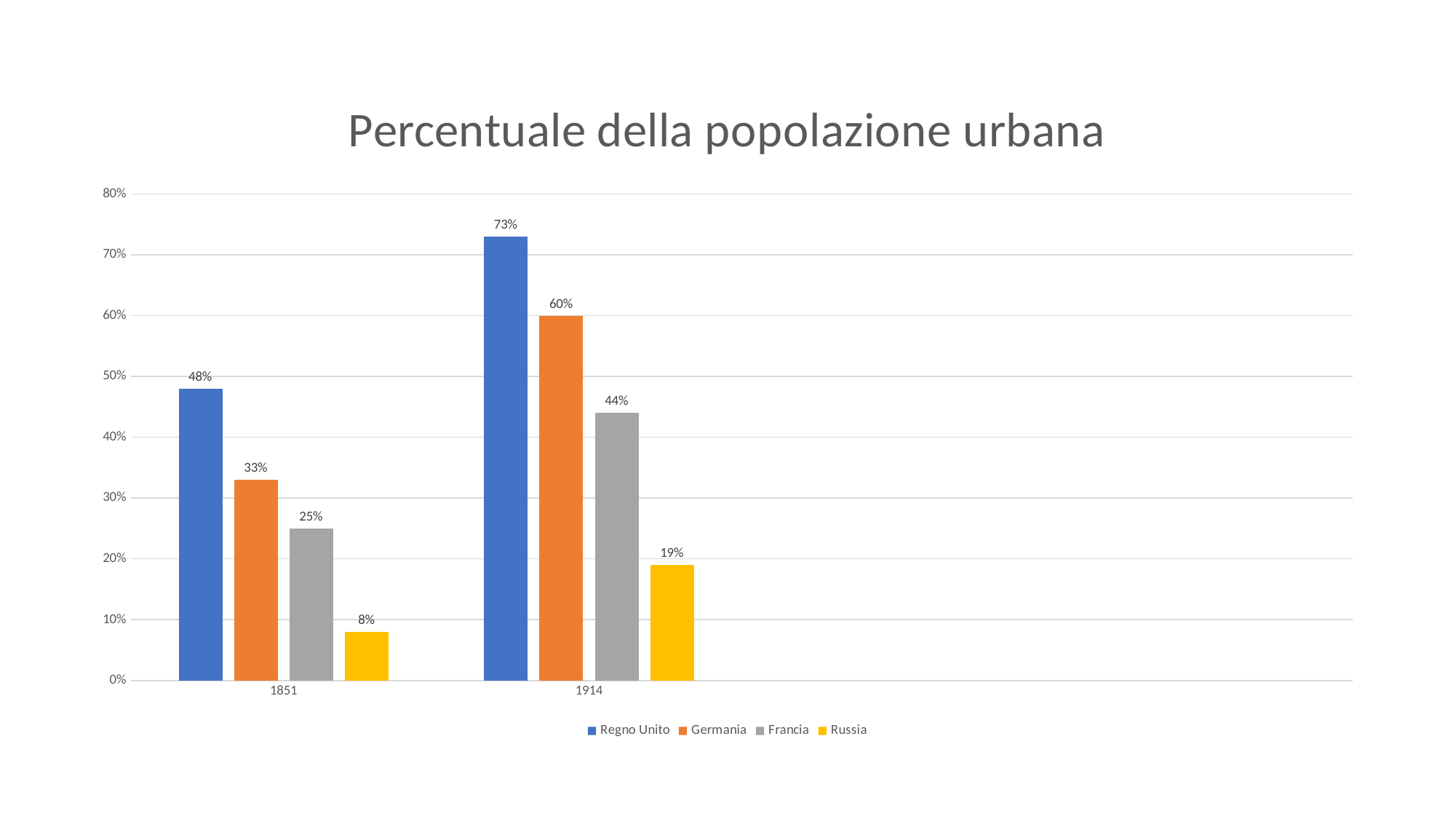
How many categories are shown on the x axis? 2 What is the value for Francia in 1914? 44% How many series does the legend list? 4 What is the value for Russia in 1914? 19% What is the title of the chart? Percentuale della popolazione urbana What is the difference between the Germania values for 1914 and 1851? 27% What is the value for Regno Unito in 1851? 48% Which is larger: Francia in 1914 or Regno Unito in 1851? Regno Unito in 1851 Which series has the lowest value in 1851? Russia Which series has the highest value in 1914? Regno Unito What kind of chart is shown on the slide? Bar chart Is the value for Germania in 1914 greater or less than 50%? greater